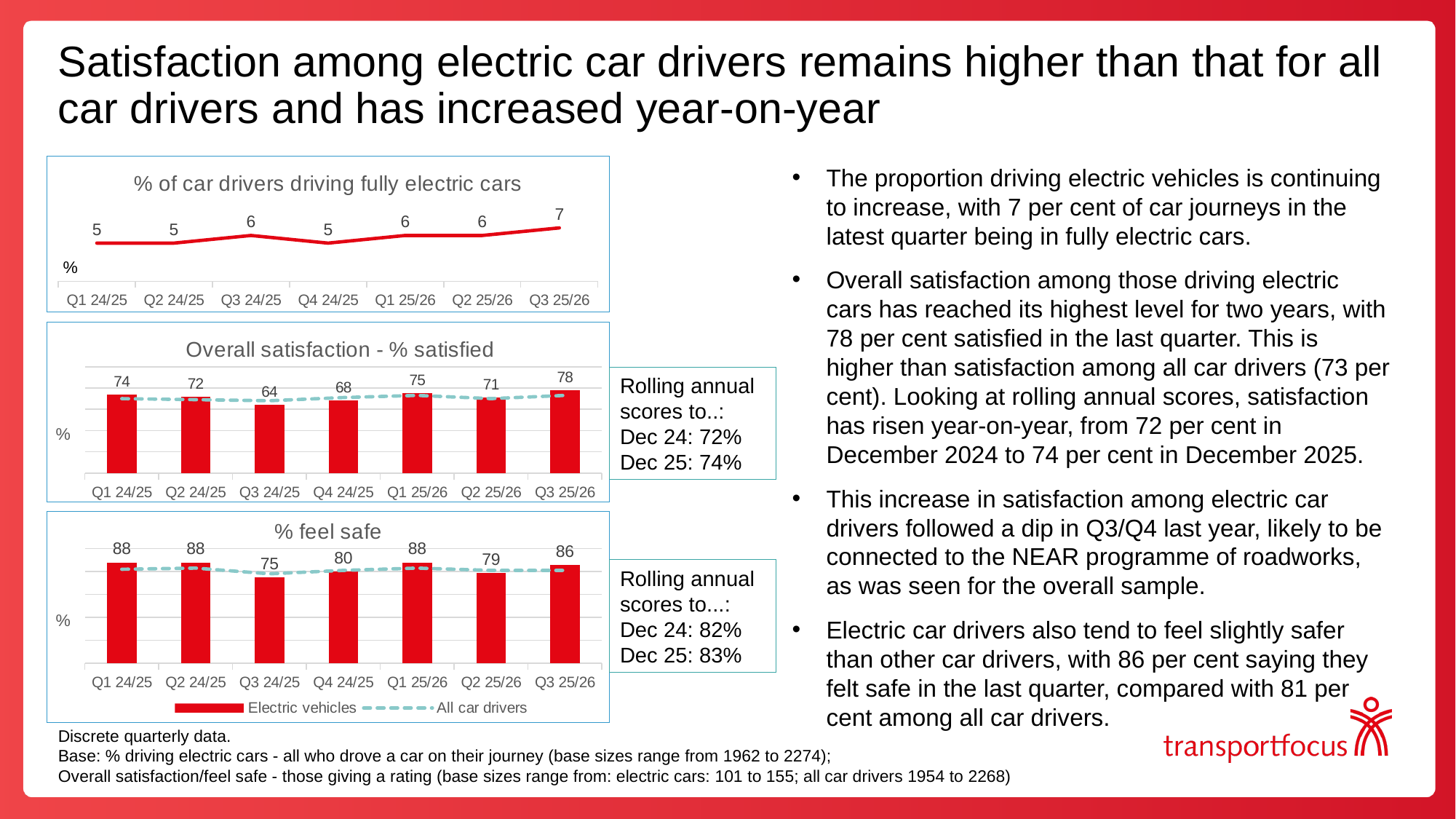
In the 'Overall satisfaction - % satisfied' chart, which quarter has the lowest Electric vehicles value? Q3 24/25 How many series does the legend of the '% feel safe' chart list? 2 In the '% feel safe' chart, what is the Electric vehicles value for Q3 24/25? 75 In the '% feel safe' chart, what is the difference between the Electric vehicles values for Q1 25/26 and Q2 25/26? 9 In the 'Overall satisfaction - % satisfied' chart, is the Electric vehicles value higher in Q1 25/26 or Q2 25/26? Q1 25/26 What kind of chart is the '% of car drivers driving fully electric cars' chart? Line chart In the 'Overall satisfaction - % satisfied' chart, what is the difference between the Electric vehicles values for Q3 25/26 and Q3 24/25? 14 In the '% feel safe' chart, which series is shown as a dashed line? All car drivers In the '% of car drivers driving fully electric cars' chart, which quarter has the highest value? Q3 25/26 How many quarters are plotted in the '% of car drivers driving fully electric cars' chart? 7 In the '% of car drivers driving fully electric cars' chart, what is the value for Q3 25/26? 7 In the 'Overall satisfaction - % satisfied' chart, what is the Electric vehicles value for Q3 25/26? 78